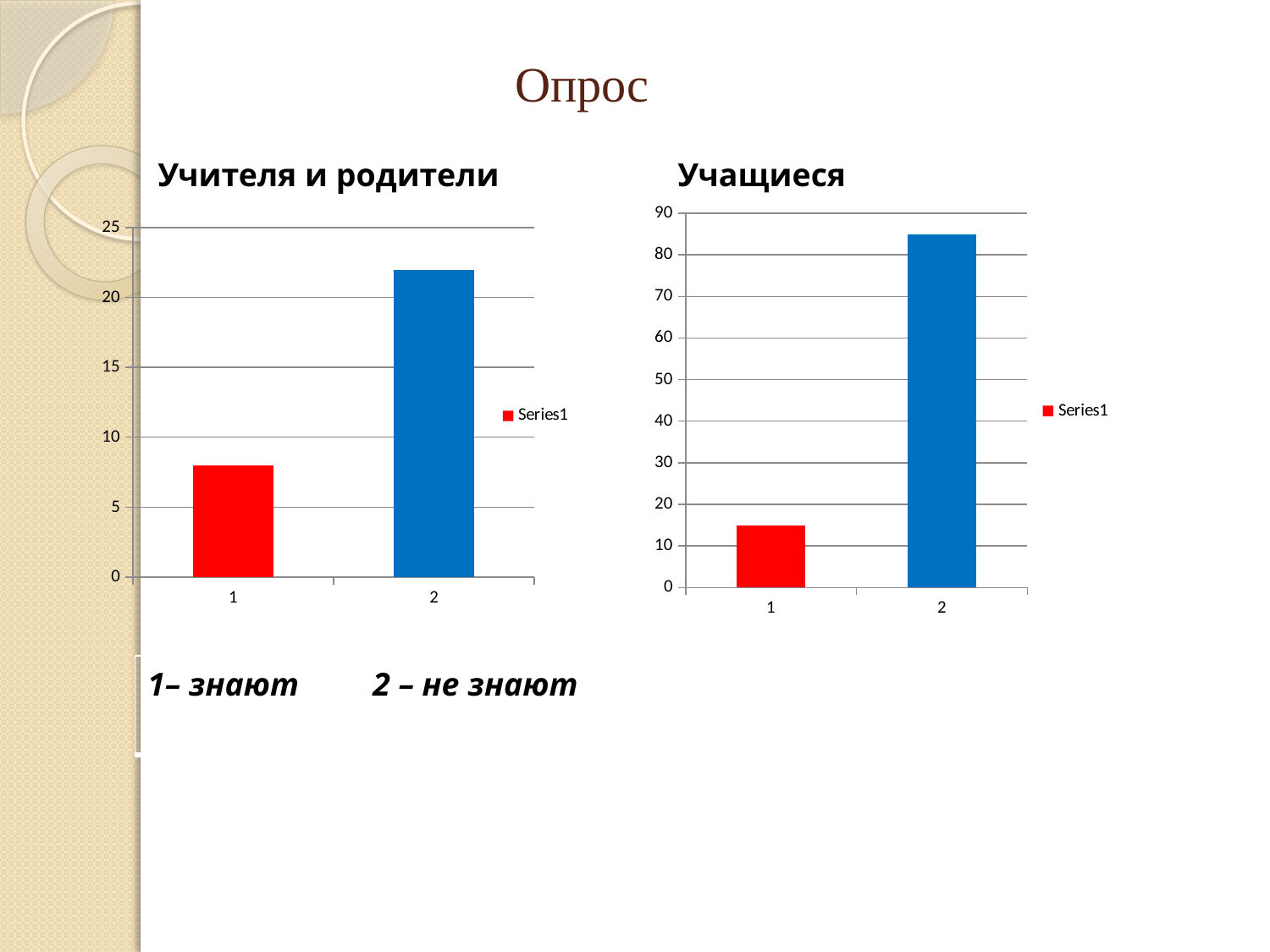
How many categories are shown in the 'Учащиеся' chart? 2 In the 'Учащиеся' chart, which category has the lowest value? 1 In the 'Учащиеся' chart, is the value for category 1 greater or less than 20? less How many series does the legend of the 'Учителя и родители' chart list? 1 In the 'Учителя и родители' chart, is the value for category 1 greater or less than 10? less In the 'Учителя и родители' chart, which category has the highest value? 2 In the 'Учащиеся' chart, is the value for category 2 greater or less than 80? greater In the 'Учителя и родители' chart, which category has the lowest value? 1 What kind of chart is the 'Учителя и родители' chart? bar chart What kind of chart is the 'Учащиеся' chart? bar chart In the 'Учащиеся' chart, which category has the highest value? 2